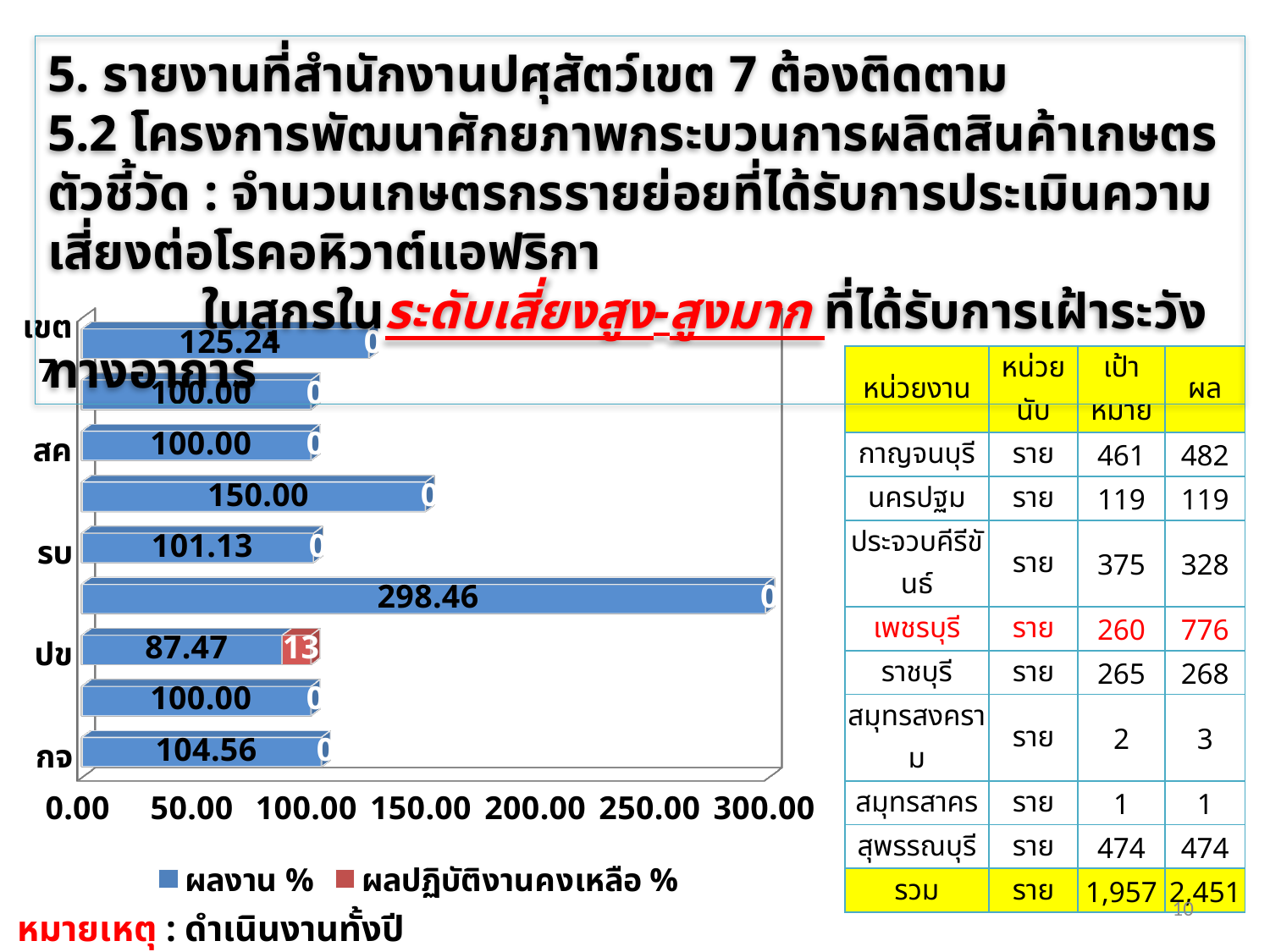
What is the ผลงาน % value for กจ? 104.56 What is the difference between the ผลงาน % values for เขต and ปข? 37.77 What is the ผลปฏิบัติงานคงเหลือ % value for ปข? 13 What is the ผลงาน % value for เขต? 125.24 What is the highest ผลงาน % value shown on the chart? 298.46 What kind of chart is shown on the slide? bar chart What is the ผลงาน % value for สค? 100.00 How many series does the legend list? 2 What is the ผลงาน % value for รบ? 101.13 Which labelled category has the lowest ผลงาน % value? ปข What is the ผลงาน % value for ปข? 87.47 Which has the larger ผลงาน % value, กจ or รบ? กจ